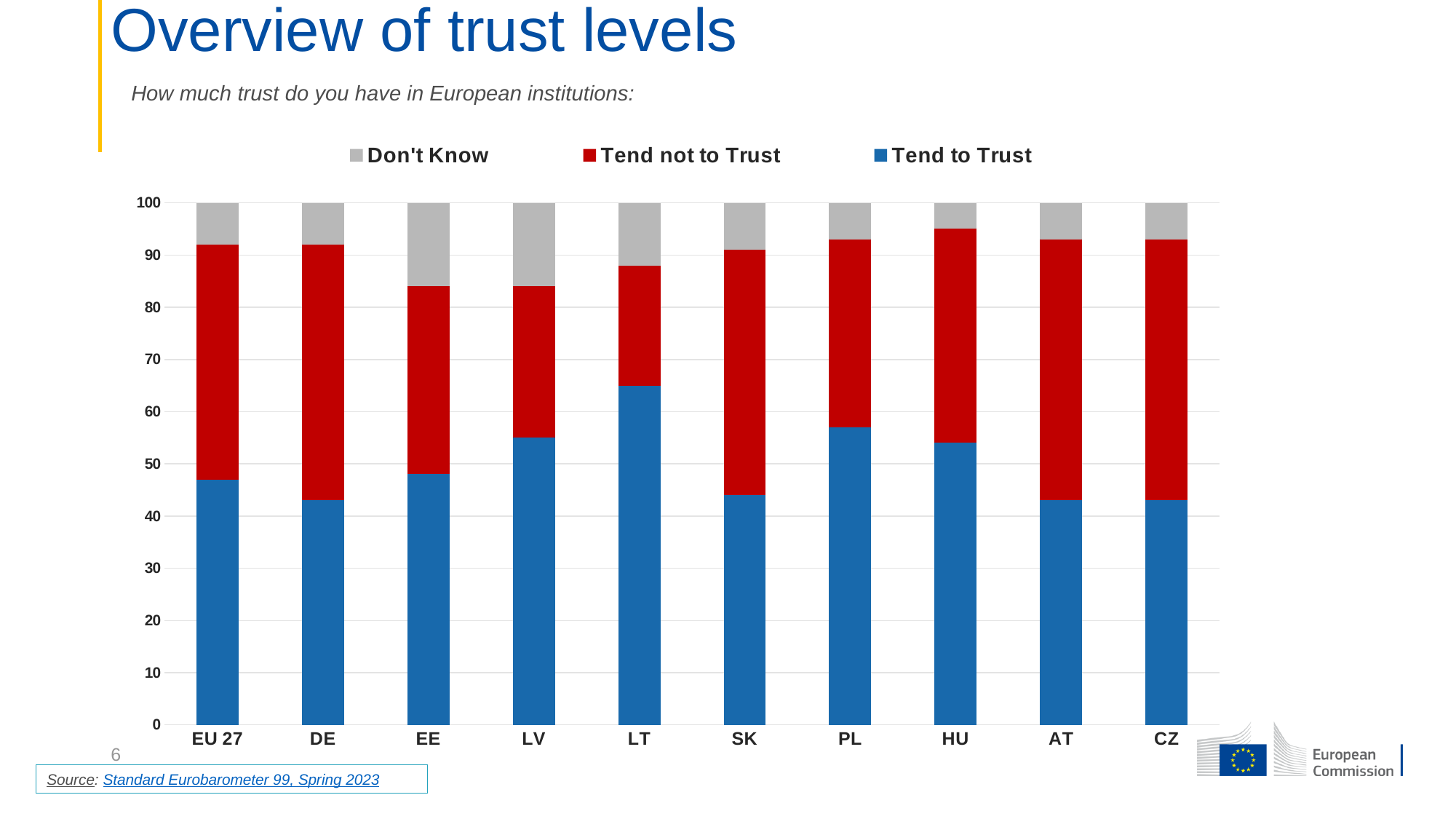
What kind of chart is shown on the slide? Stacked bar chart What source is cited for the chart? Standard Eurobarometer 99, Spring 2023 Is the Tend to Trust value for DE greater or less than 50? less What is the total of the stacked bar for EU 27? 100 How many series does the legend list? 3 Which has a larger Tend to Trust value, LT or DE? LT Which category has the highest Tend to Trust value? LT Is the Tend to Trust value for LV greater or less than 50? greater Which has a larger Tend to Trust value, PL or SK? PL How many countries or groups are shown on the x axis? 10 Is the Tend to Trust value for LT greater or less than 60? greater Which colour represents Tend to Trust in the legend? Blue